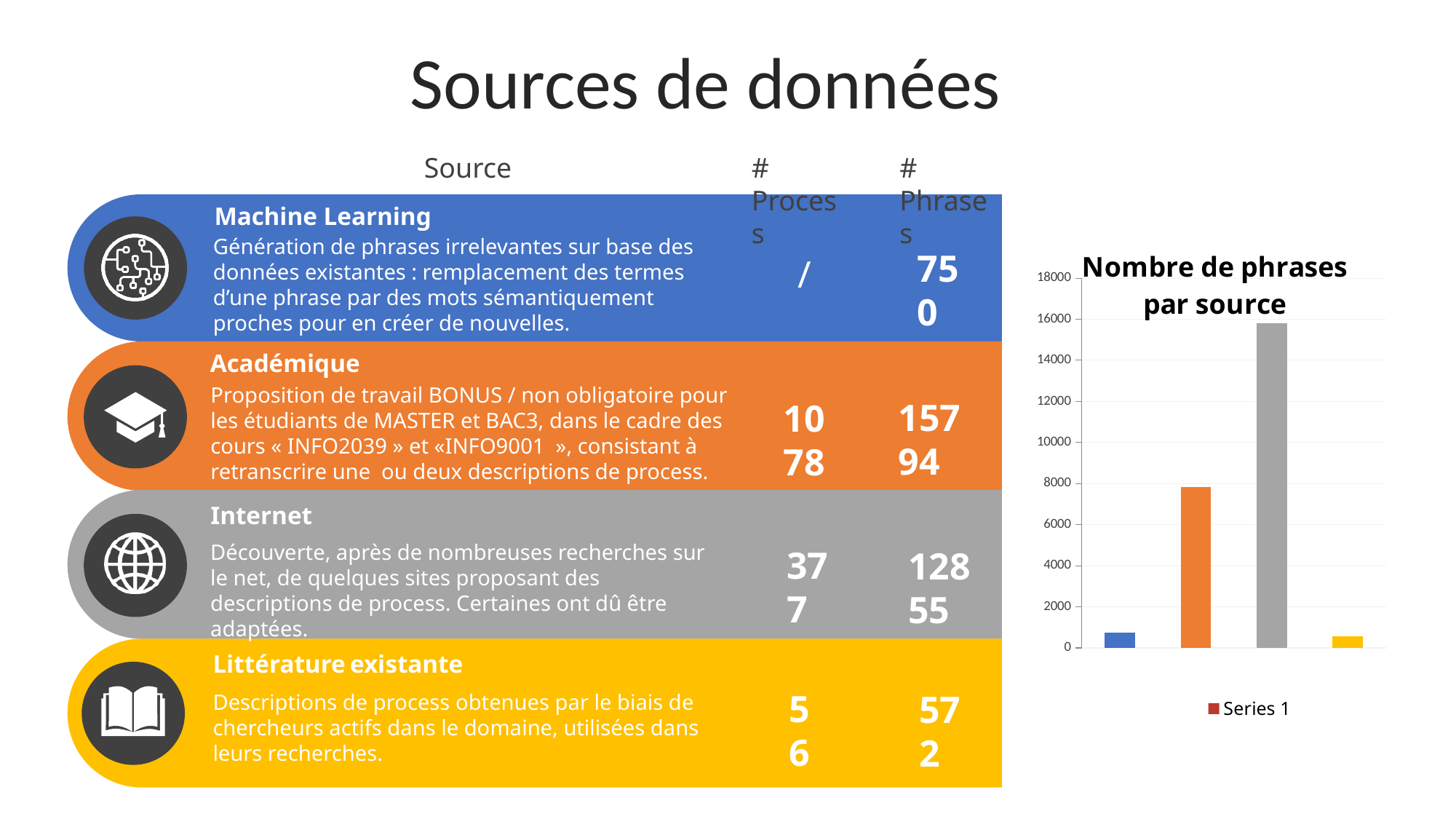
What is the title of the chart on the right of the slide? Nombre de phrases par source Is the value of the second (orange) bar greater or less than 6000? greater How many series does the chart legend list? 1 Is the value of the fourth (yellow) bar greater or less than 2000? less Which bar in the chart is the tallest? the third (gray) bar Which bar in the chart is the shortest? the fourth (yellow) bar What is the legend entry shown below the chart? Series 1 Which is larger, the second (orange) bar or the third (gray) bar? the third (gray) bar Is the value of the first (blue) bar greater or less than 2000? less How many bars are plotted in the chart? 4 What kind of chart is shown on the slide? bar chart